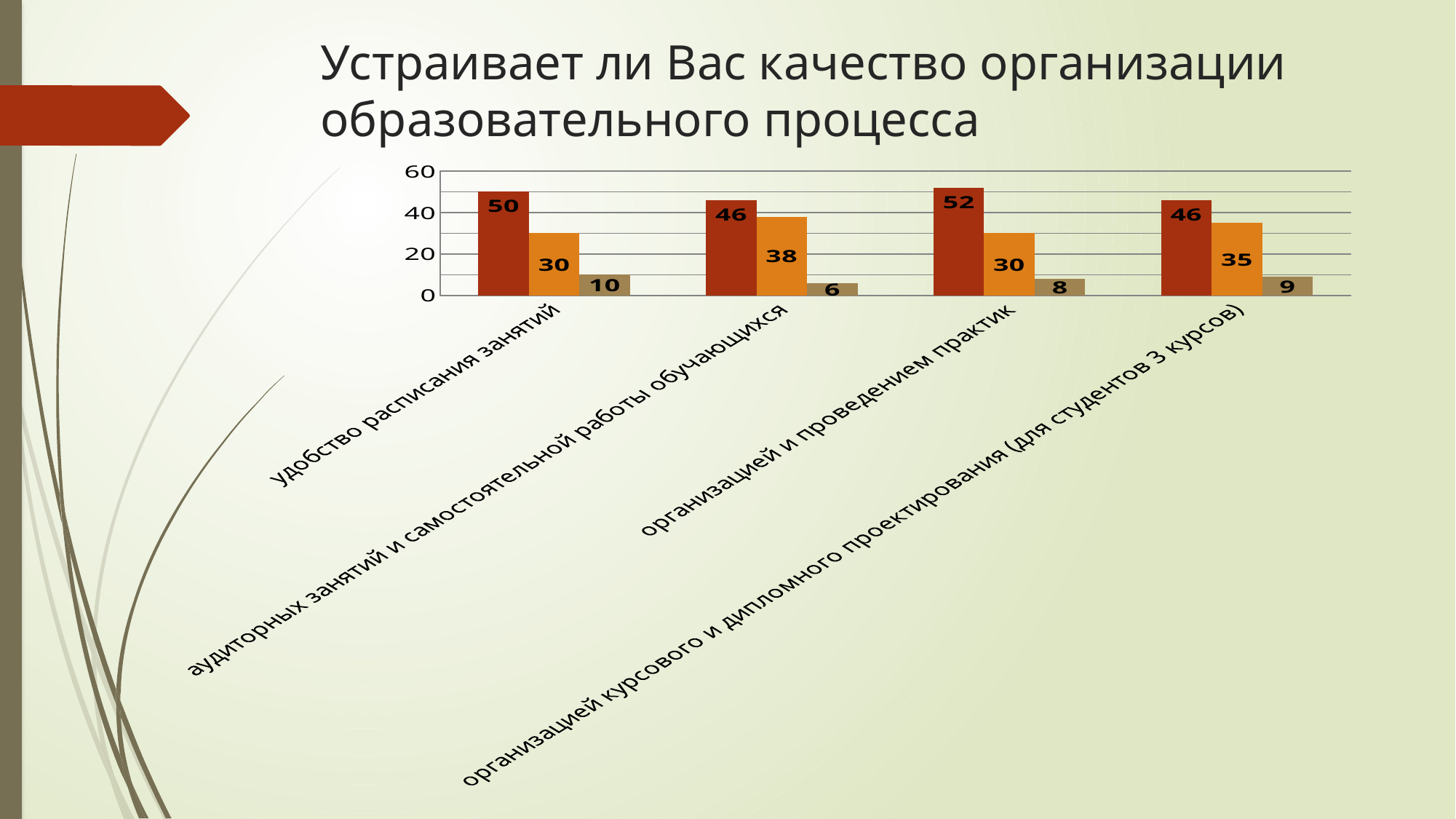
What is the value of the orange bar for "аудиторных занятий и самостоятельной работы обучающихся"? 38 What is the value of the dark red bar for "удобство расписания занятий"? 50 What is the value of the orange bar for "организацией курсового и дипломного проектирования (для студентов 3 курсов)"? 35 What is the title of the slide? Устраивает ли Вас качество организации образовательного процесса How many bars are shown for each category? 3 Which category has the highest dark red bar? организацией и проведением практик How many categories are shown on the x axis? 4 What is the value of the brown bar for "организацией и проведением практик"? 8 What kind of chart is shown on the slide? bar chart Which is larger: the orange bar for "аудиторных занятий и самостоятельной работы обучающихся" or the orange bar for "организацией и проведением практик"? аудиторных занятий и самостоятельной работы обучающихся What is the difference between the dark red bar and the orange bar for "удобство расписания занятий"? 20 Which category has the lowest brown bar? аудиторных занятий и самостоятельной работы обучающихся